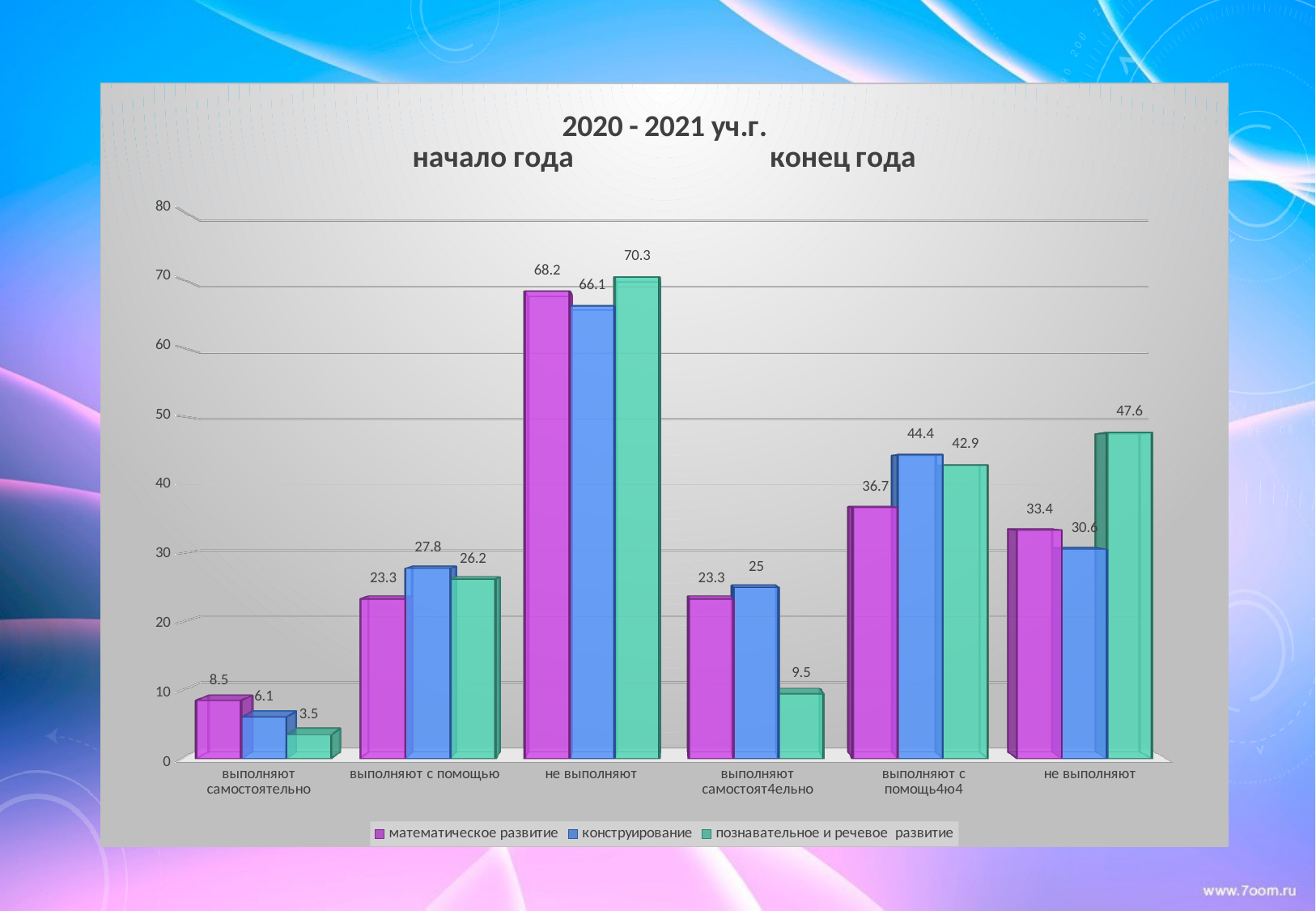
How many series does the legend list? 3 What is the difference between the математическое развитие values for 'не выполняют' at the start of the year (68.2) and at the end of the year (33.4)? 34.8 Which series has the highest value in the 'не выполняют' category at the end of the year (конец года)? познавательное и речевое развитие What is the value for математическое развитие in the 'выполняют с помощью' category at the end of the year (конец года)? 36.7 Which is larger: the конструирование value for 'выполняют с помощью' at the end of the year or the математическое развитие value in the same category? конструирование What colour are the bars for математическое развитие? purple What is the value for познавательное и речевое развитие in the 'не выполняют' category at the start of the year (начало года)? 70.3 Which series has the lowest value in the 'выполняют самостоятельно' category at the start of the year (начало года)? познавательное и речевое развитие What kind of chart is shown on the slide? bar chart What is the value for познавательное и речевое развитие in the 'выполняют самостоятельно' category at the end of the year (конец года)? 9.5 How many categories are shown along the x axis? 6 What is the value for конструирование in the 'выполняют с помощью' category at the start of the year (начало года)? 27.8